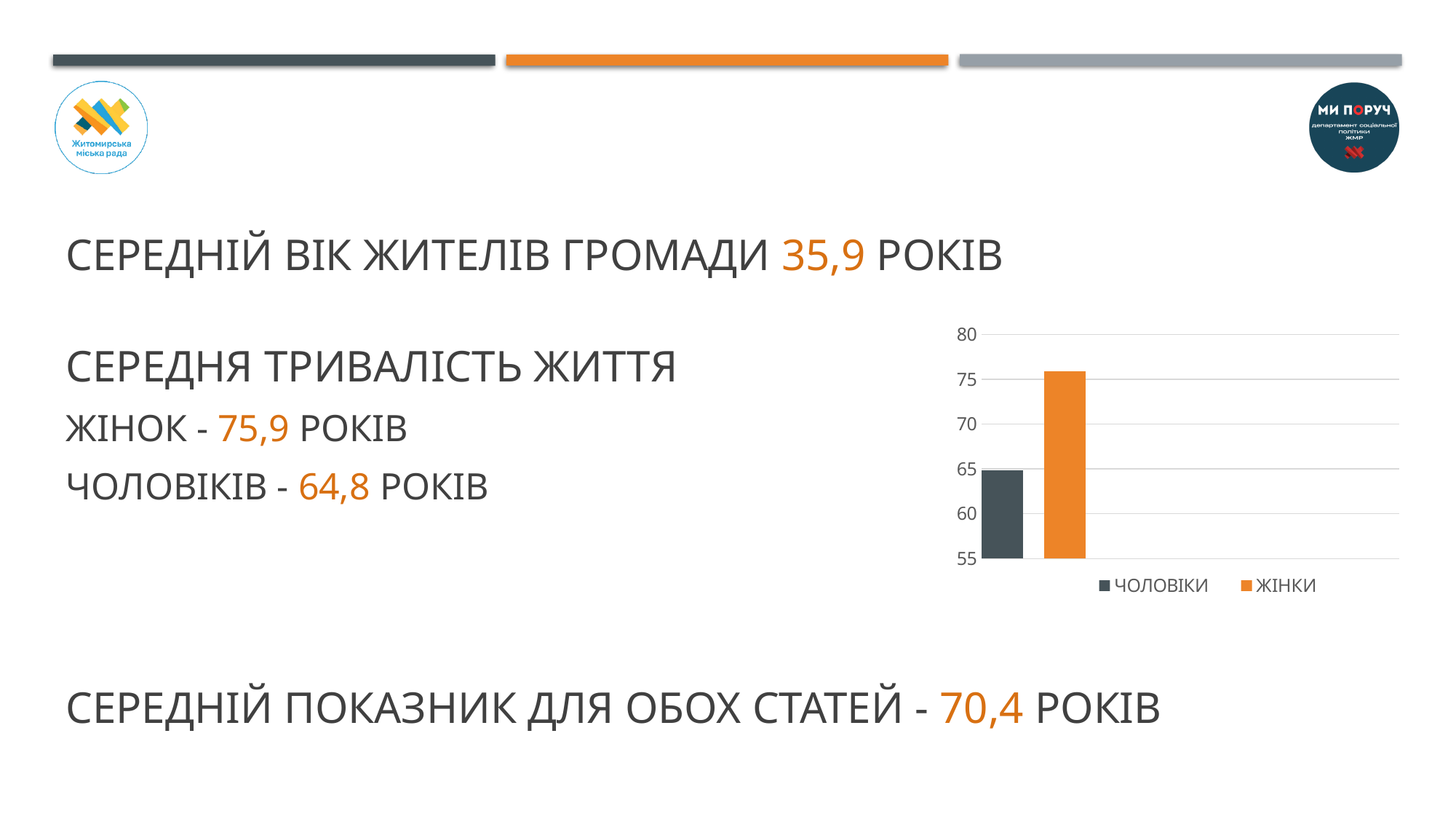
Is the value for ЧОЛОВІКИ in the chart greater or less than 65? less How many series does the chart legend list? 2 Is the value for ЧОЛОВІКИ in the chart greater or less than 60? greater What colour is the bar for ЖІНКИ in the chart? orange What kind of chart is shown on the slide? bar chart Which series has the taller bar in the chart, ЧОЛОВІКИ or ЖІНКИ? ЖІНКИ Which series has the highest value in the chart? ЖІНКИ Is the value for ЖІНКИ in the chart greater or less than 75? greater What are the two series named in the chart legend? ЧОЛОВІКИ and ЖІНКИ Which series has the lowest value in the chart? ЧОЛОВІКИ According to the slide, what is the average life expectancy for men (ЧОЛОВІКИ) shown in the chart? 64,8 років According to the slide, what is the average life expectancy for women (ЖІНКИ) shown in the chart? 75,9 років